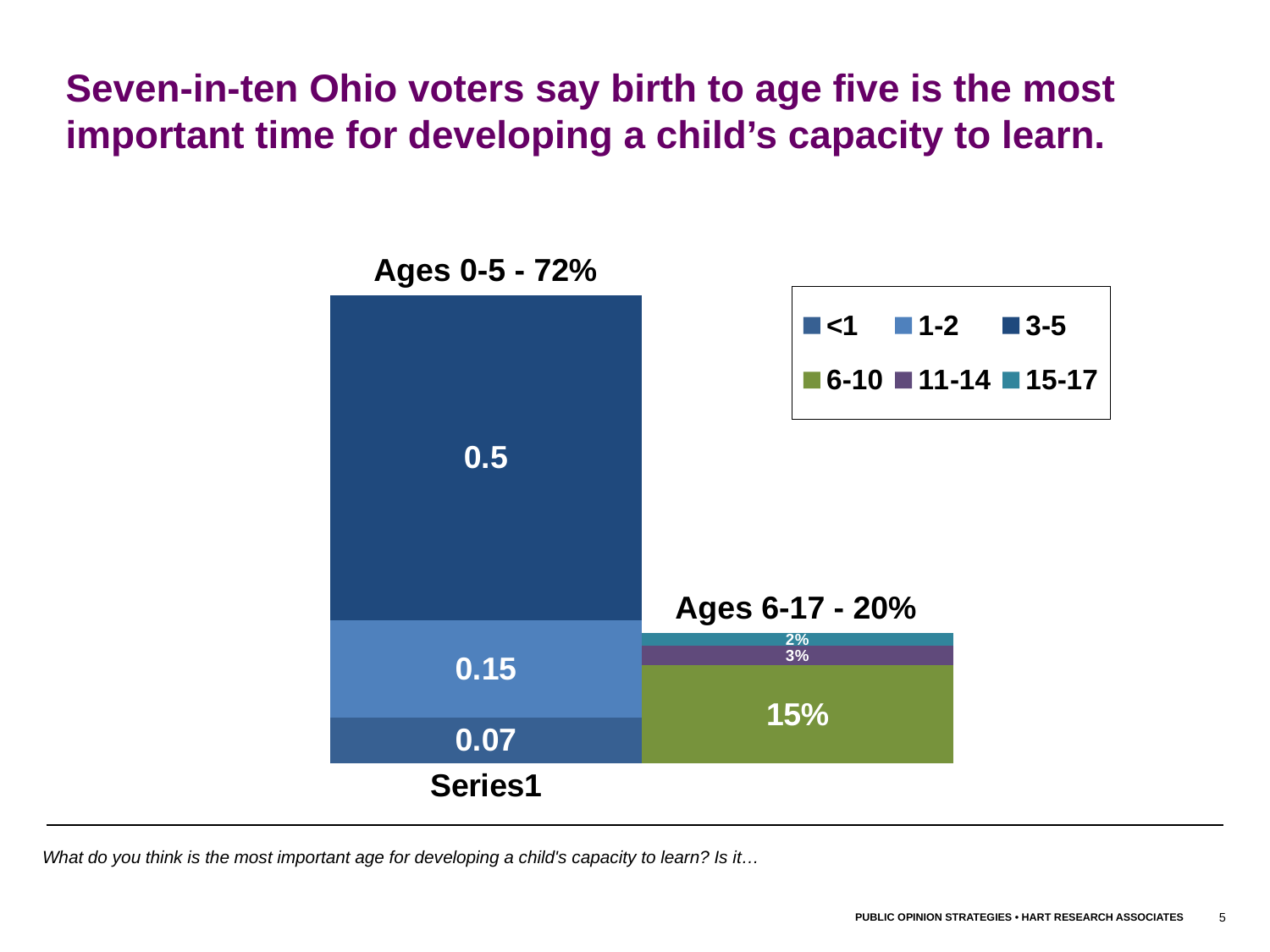
What value is shown for the 6-10 segment? 15% Which age group segment has the largest value? 3-5 What kind of chart is shown on the slide? Stacked bar chart What is the total shown for the Ages 0-5 stack? 72% What value is shown for the 1-2 segment? 0.15 What is the total shown for the Ages 6-17 stack? 20% What value is shown for the 15-17 segment? 2% What value is shown for the 3-5 segment of the stacked bar? 0.5 What value is shown for the <1 segment? 0.07 Which is larger, the value for 1-2 or the value for <1? 1-2 What value is shown for the 11-14 segment? 3% How many series does the legend list? 6